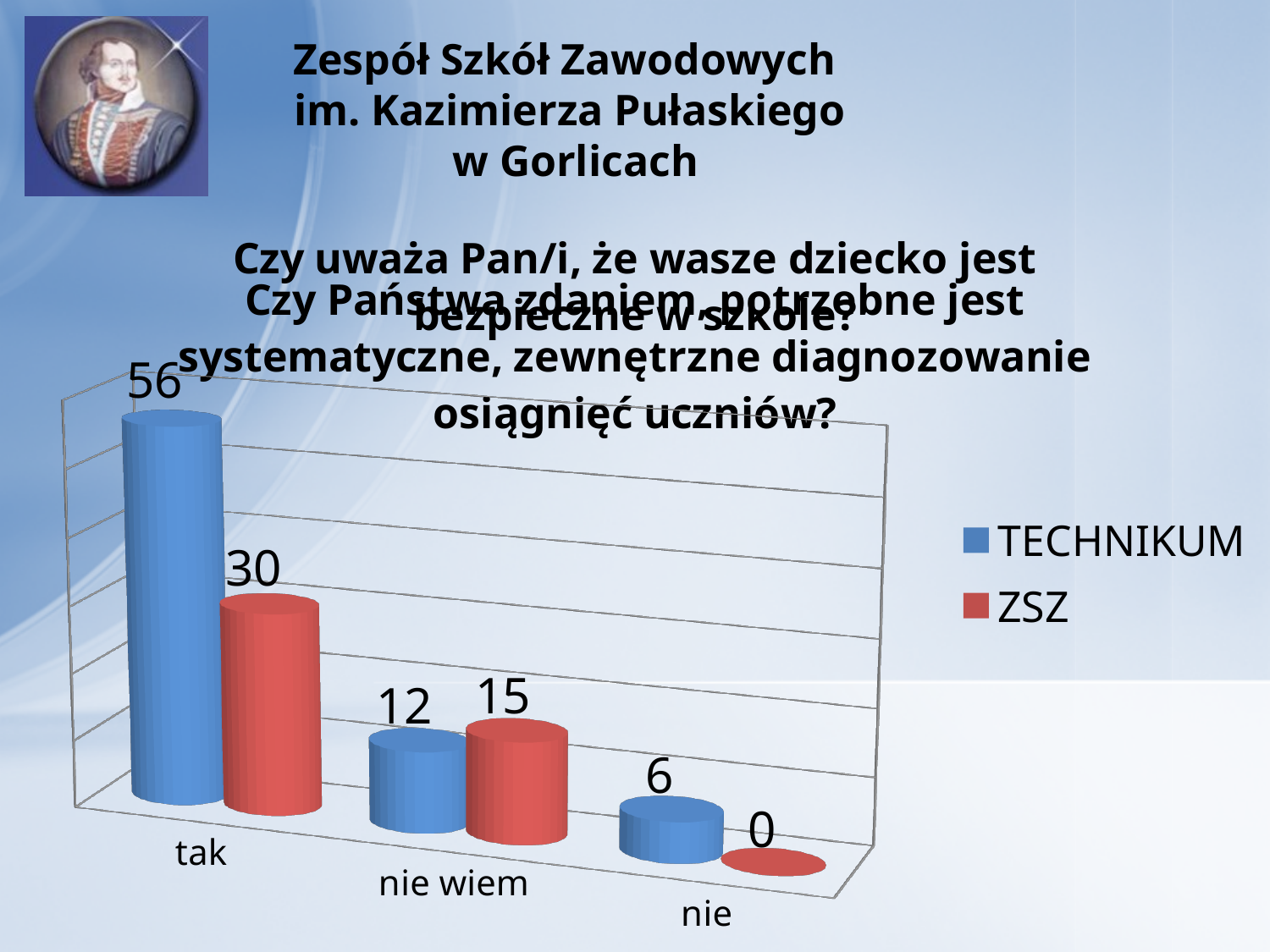
Which category has the lowest ZSZ value? nie What is the TECHNIKUM value for "tak"? 56 Which category has the highest TECHNIKUM value? tak What is the TECHNIKUM value for "nie wiem"? 12 What is the ZSZ value for "nie"? 0 What kind of chart is shown on the slide? bar chart Which colour represents the ZSZ series in the legend? red How many series does the legend list? 2 For "nie wiem", which series has the larger value, TECHNIKUM or ZSZ? ZSZ What is the ZSZ value for "tak"? 30 How many categories are shown on the x axis? 3 What is the difference between the TECHNIKUM and ZSZ values for "tak"? 26